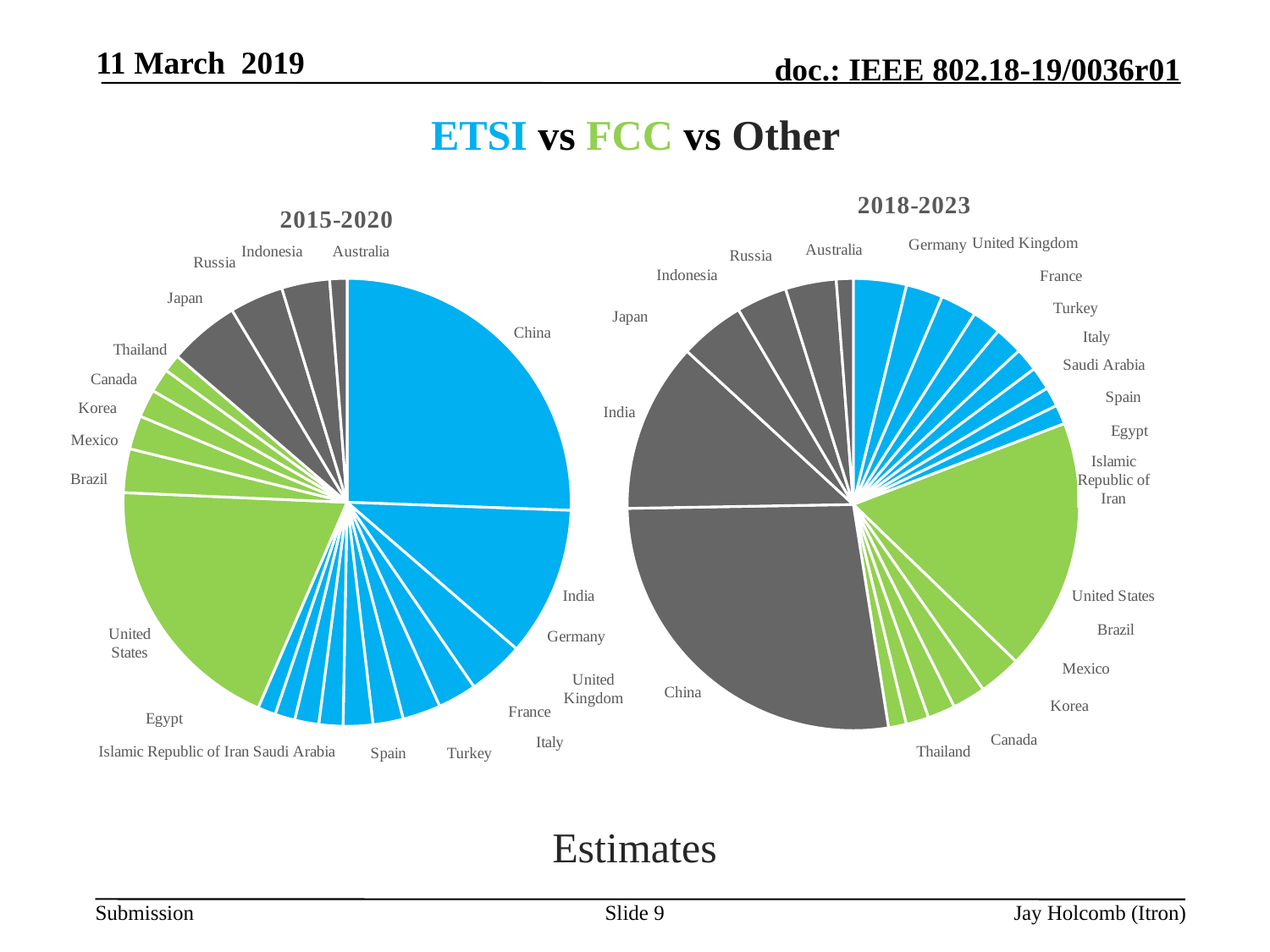
What kind of chart is the 2018-2023 chart? pie chart What kind of chart is the 2015-2020 chart? pie chart In the 2018-2023 chart, which country has the largest slice? China In the 2018-2023 chart, which slice is larger, India or Japan? India In the 2018-2023 chart, what colour is the China slice? gray In the 2015-2020 chart, which country has the largest slice? China What is the title of the slide containing the two pie charts? ETSI vs FCC vs Other How many countries are shown as slices in the 2015-2020 chart? 21 In the 2015-2020 chart, which slice is larger, China or United States? China In the 2015-2020 chart, which slice is larger, India or Germany? India